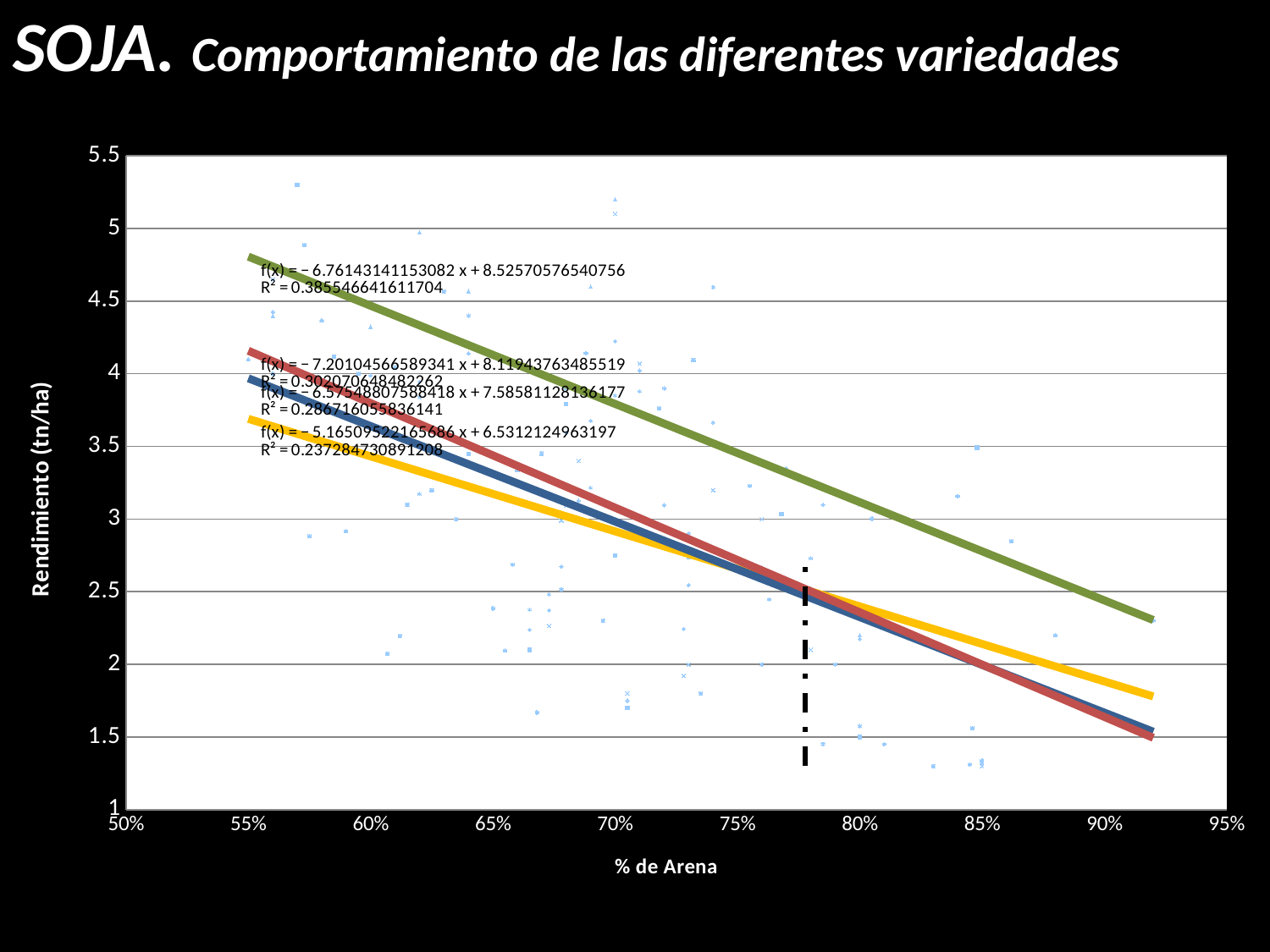
Is the value of the yellow trend line at 55% de Arena greater or less than 4? less What kind of chart is shown on the slide? scatter chart What is the title of the y axis? Rendimiento (tn/ha) What is the title of the x axis? % de Arena Which coloured trend line lies highest across the whole chart? green What is the R² value printed for the topmost equation, f(x) = -6.76143141153082 x + 8.52570576540756? 0.385546641611704 Do the trend lines rise or fall as % de Arena increases? fall Is the value of the green trend line at 90% de Arena greater or less than 2? greater What is the lowest R² value printed on the chart? 0.237284730891208 At 92% de Arena, is the green trend line or the red trend line higher? green How many coloured trend lines are drawn on the chart? 4 What is the highest R² value printed on the chart? 0.385546641611704